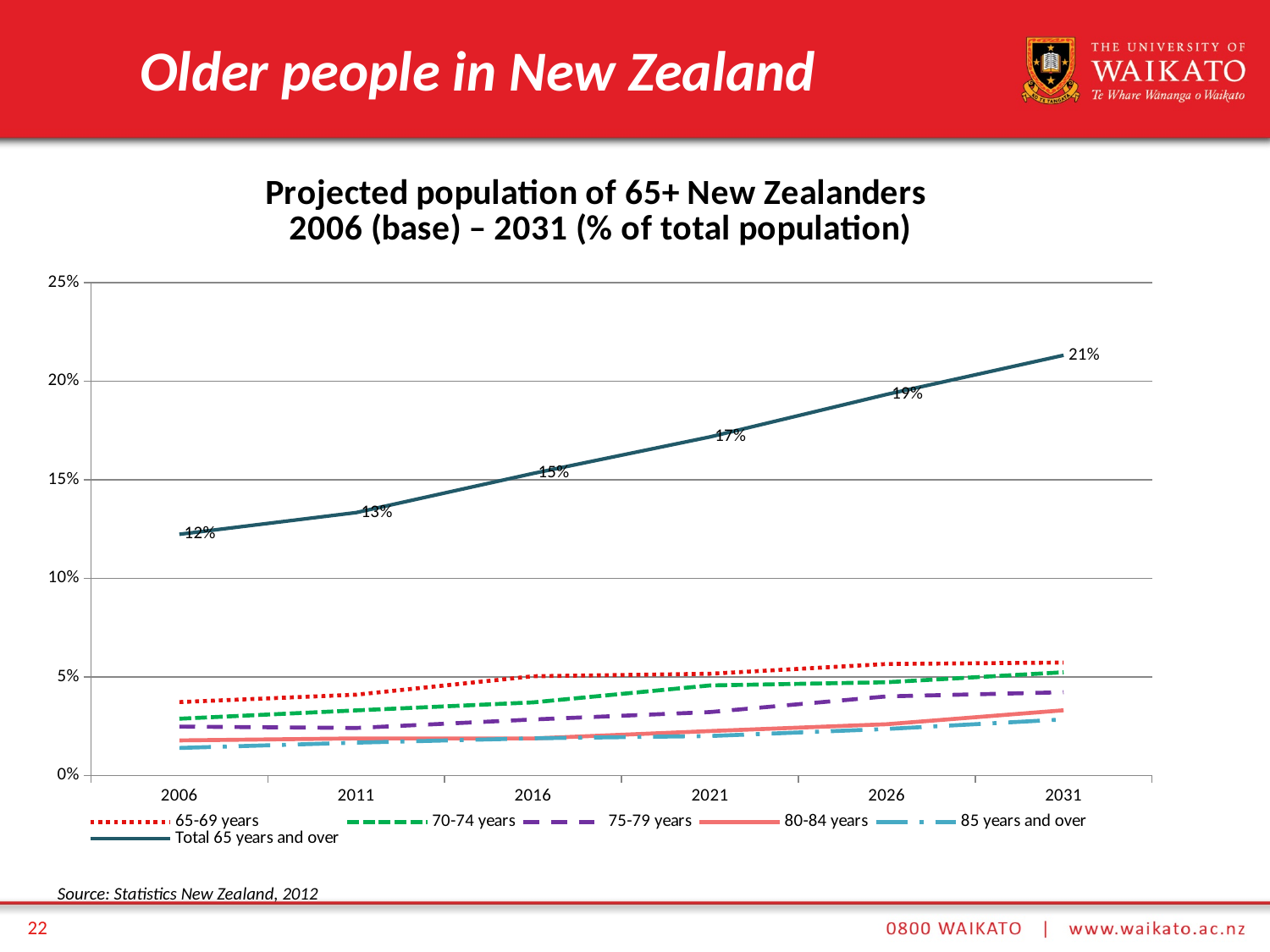
Which is larger in 2031, the value for 65-69 years or the value for 85 years and over? 65-69 years What is the value for Total 65 years and over in 2021? 17% In which year is the Total 65 years and over value highest? 2031 What is the value for Total 65 years and over in 2006? 12% Is the value for 65-69 years in 2031 greater or less than 10%? less How many years are shown on the x axis? 6 Does the Total 65 years and over series rise or fall from 2006 to 2031? rise What is the value for Total 65 years and over in 2031? 21% How many series does the legend list? 6 In which year is the Total 65 years and over value lowest? 2006 What kind of chart is shown on the slide? line chart What is the difference between the Total 65 years and over values for 2031 and 2006? 9%